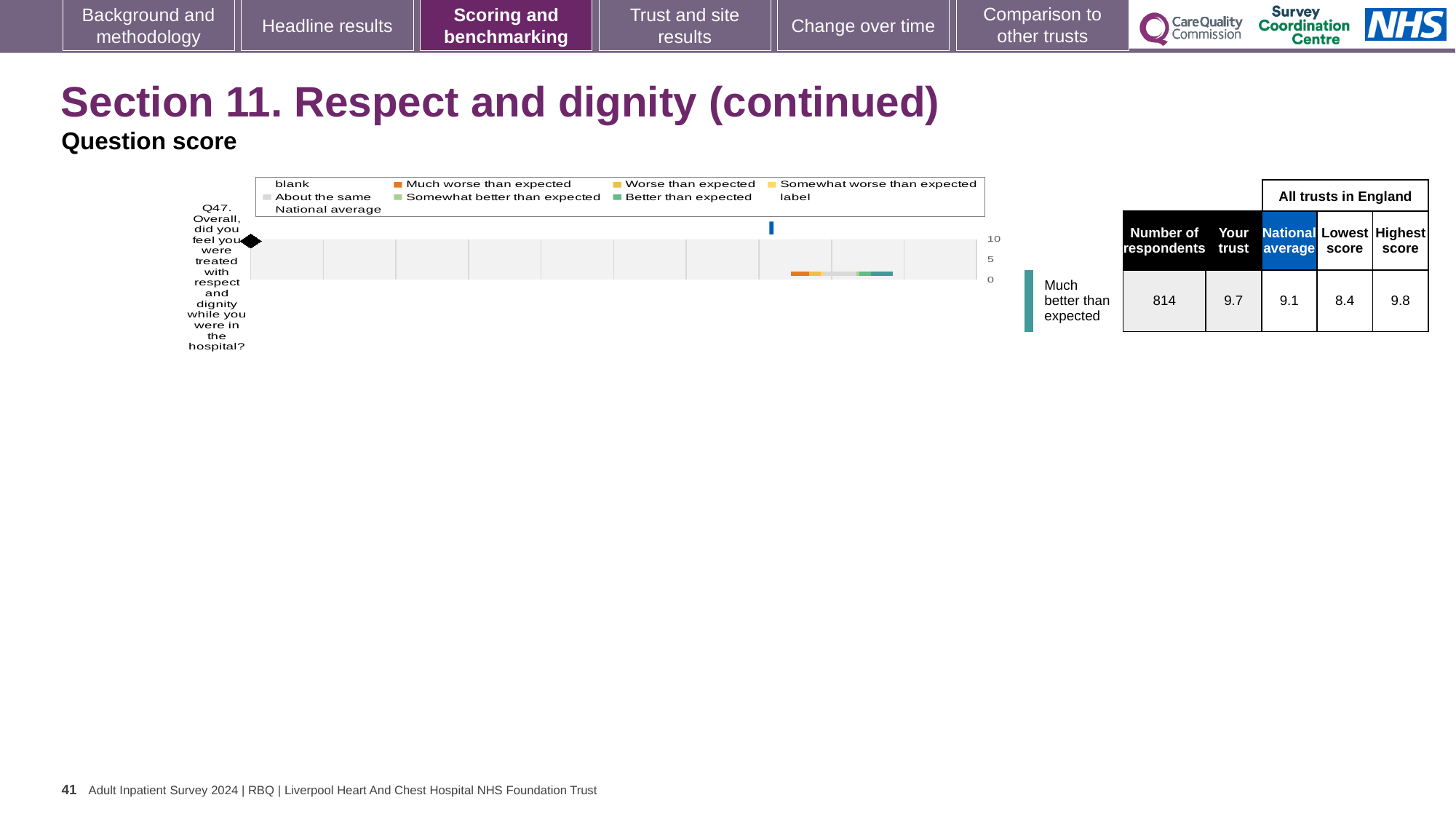
What is the lowest score among all trusts in England for Q47? 8.4 What rating category is shown for Q47 next to the chart? Much better than expected What is the highest tick value shown on the chart's score axis? 10 What kind of chart is shown on the slide for Q47? Bar chart How many respondents are reported for Q47? 814 By how much does the 'Your trust' score for Q47 exceed the national average? 0.6 What is the 'Your trust' score for Q47? 9.7 How many entries does the chart's legend list? 9 How many questions (categories) are plotted on the chart? 1 What is the highest score among all trusts in England for Q47? 9.8 Which survey question is plotted on the chart? Q47. Overall, did you feel you were treated with respect and dignity while you were in the hospital? What is the national average score for Q47? 9.1